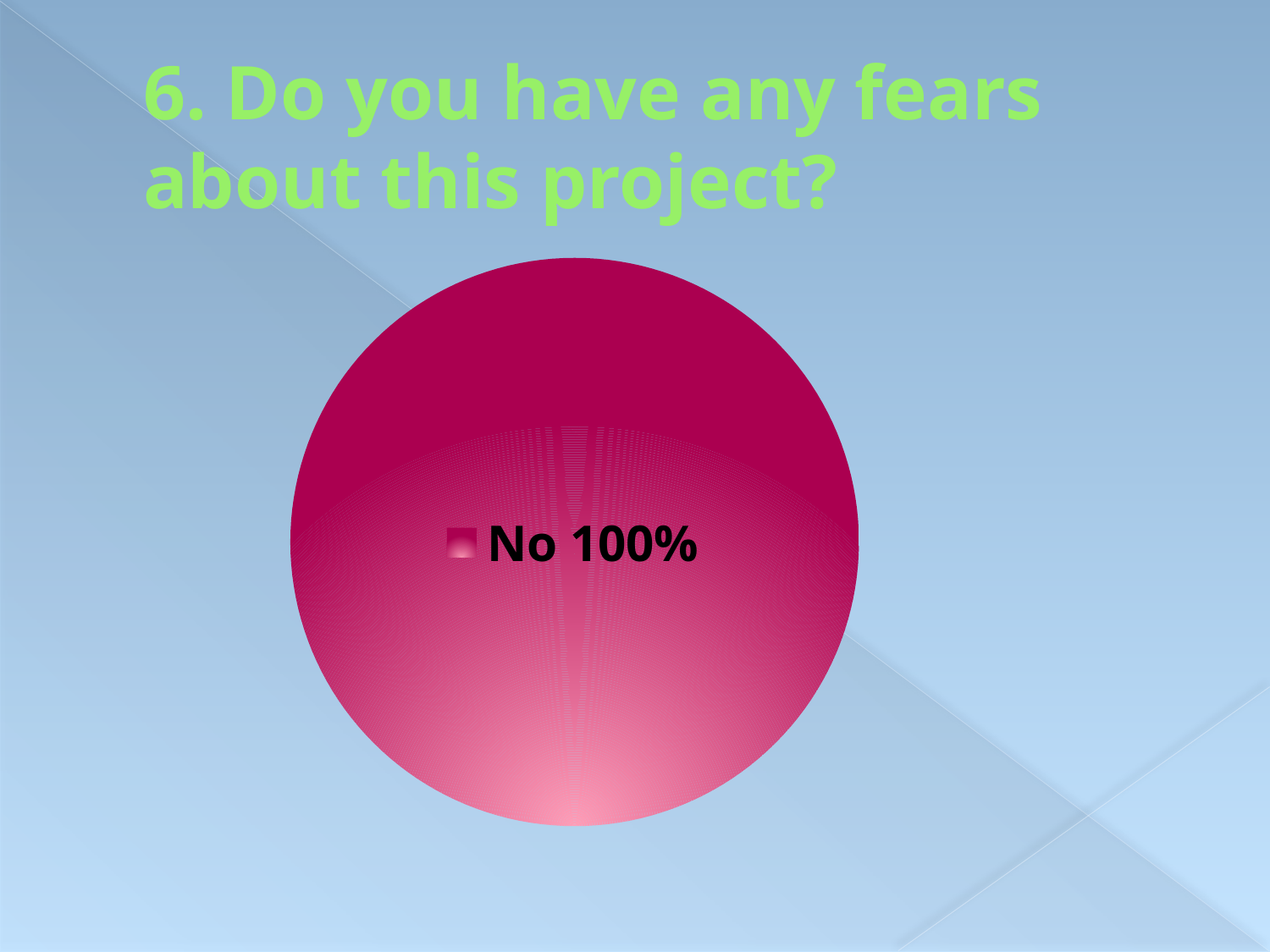
What share of the pie does the "No" slice represent? 100% What is the title of the slide containing the pie chart? 6. Do you have any fears about this project? What kind of chart is shown on the slide? pie chart Is the share for "No" greater or less than 50%? greater Which category is shown in the pie chart? No How many slices does the pie chart have? 1 What colour is the "No" slice of the pie chart? magenta/pink